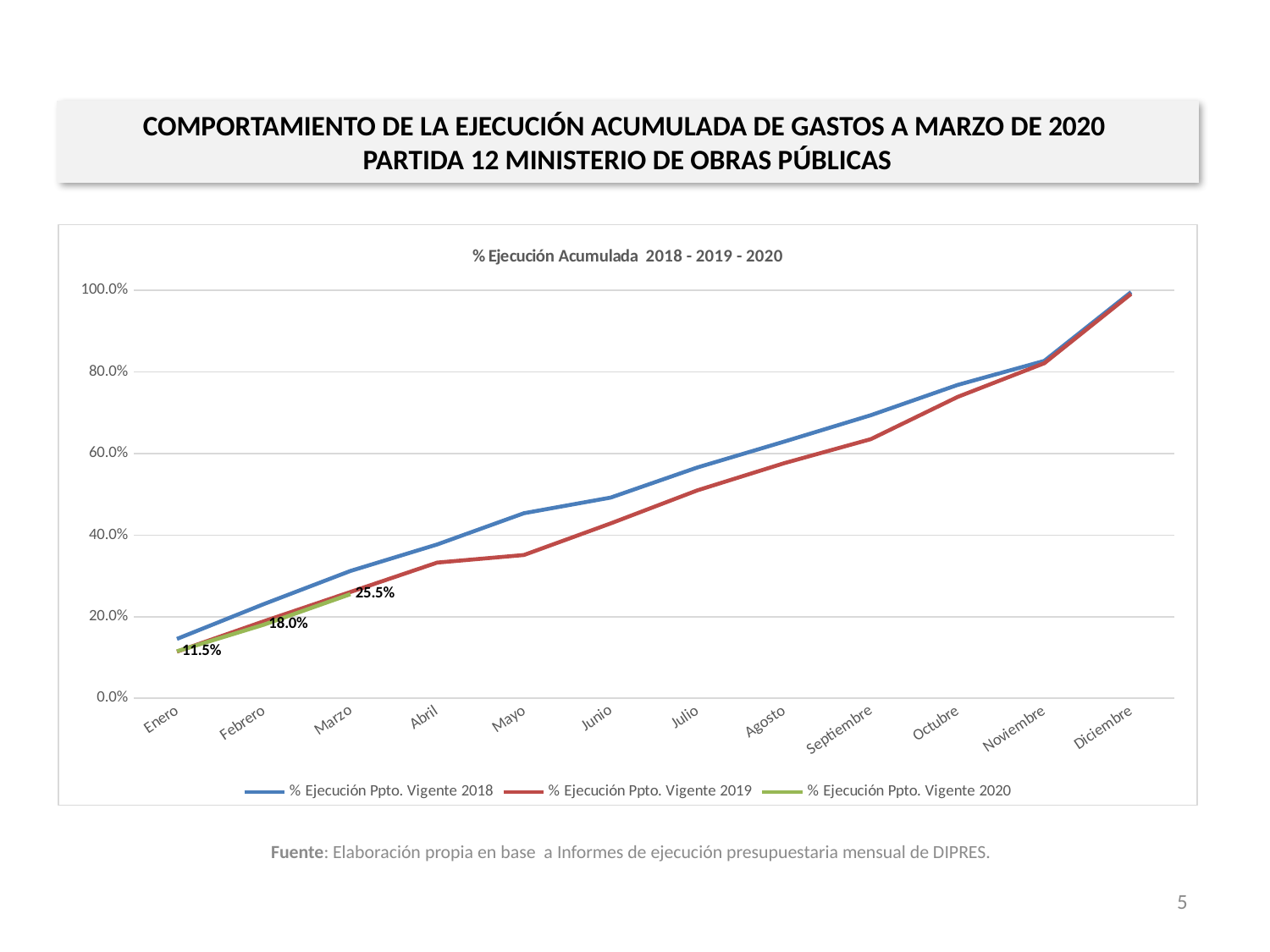
What is the title of the chart? % Ejecución Acumulada 2018 - 2019 - 2020 What kind of chart is shown on the slide? Line chart In the 2020 series, how many percentage points higher is Marzo than Enero? 14.0 How many series does the legend list? 3 What is the value for Enero in the % Ejecución Ppto. Vigente 2020 series? 11.5% What is the value for Marzo in the % Ejecución Ppto. Vigente 2020 series? 25.5% What is the value for Febrero in the % Ejecución Ppto. Vigente 2020 series? 18.0% How many months are shown on the x axis? 12 In Mayo, which series has the larger value, 2018 or 2019? 2018 Do the values of the 2018 series rise or fall from Enero to Diciembre? Rise Is the value for Abril in the 2019 series greater or less than 40%? less Is the value for Mayo in the 2018 series greater or less than 40%? greater